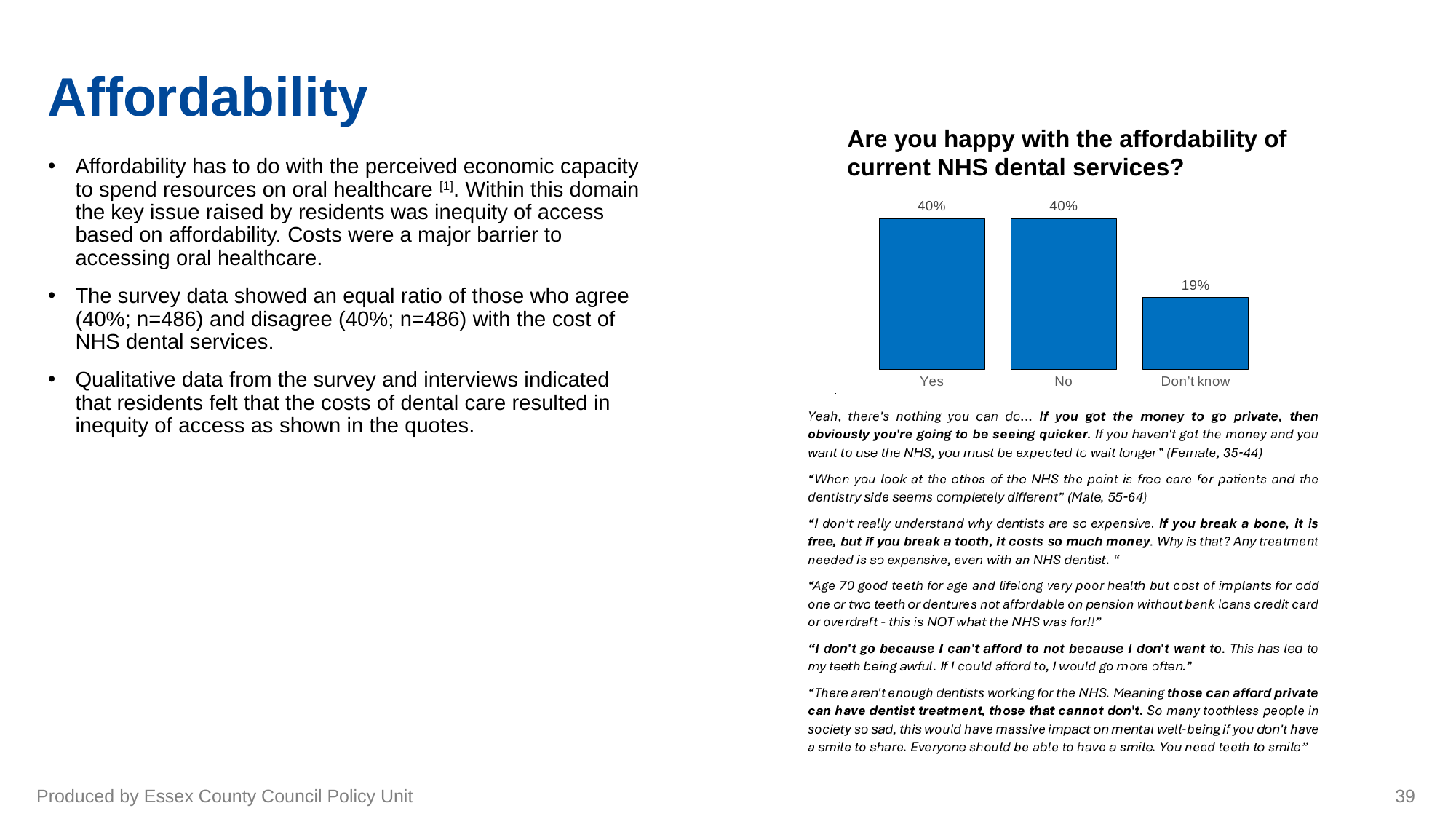
What percentage of respondents answered "No" in the affordability chart? 40% Which response category has the lowest value in the chart? Don't know What percentage of respondents answered "Don't know" in the affordability chart? 19% What is the title of the chart on the slide? Are you happy with the affordability of current NHS dental services? What colour are the bars in the chart? Blue Do the "Yes" and "No" bars in the chart have the same value? Yes How many response categories are shown in the chart? 3 What percentage of respondents answered "Yes" to being happy with the affordability of current NHS dental services? 40% What is the combined value of the "Yes" and "No" responses in the chart? 80% What is the difference between the "Yes" and "Don't know" values in the chart? 21% Is the value for "No" larger than the value for "Don't know"? Yes What kind of chart is shown on the slide? Bar chart